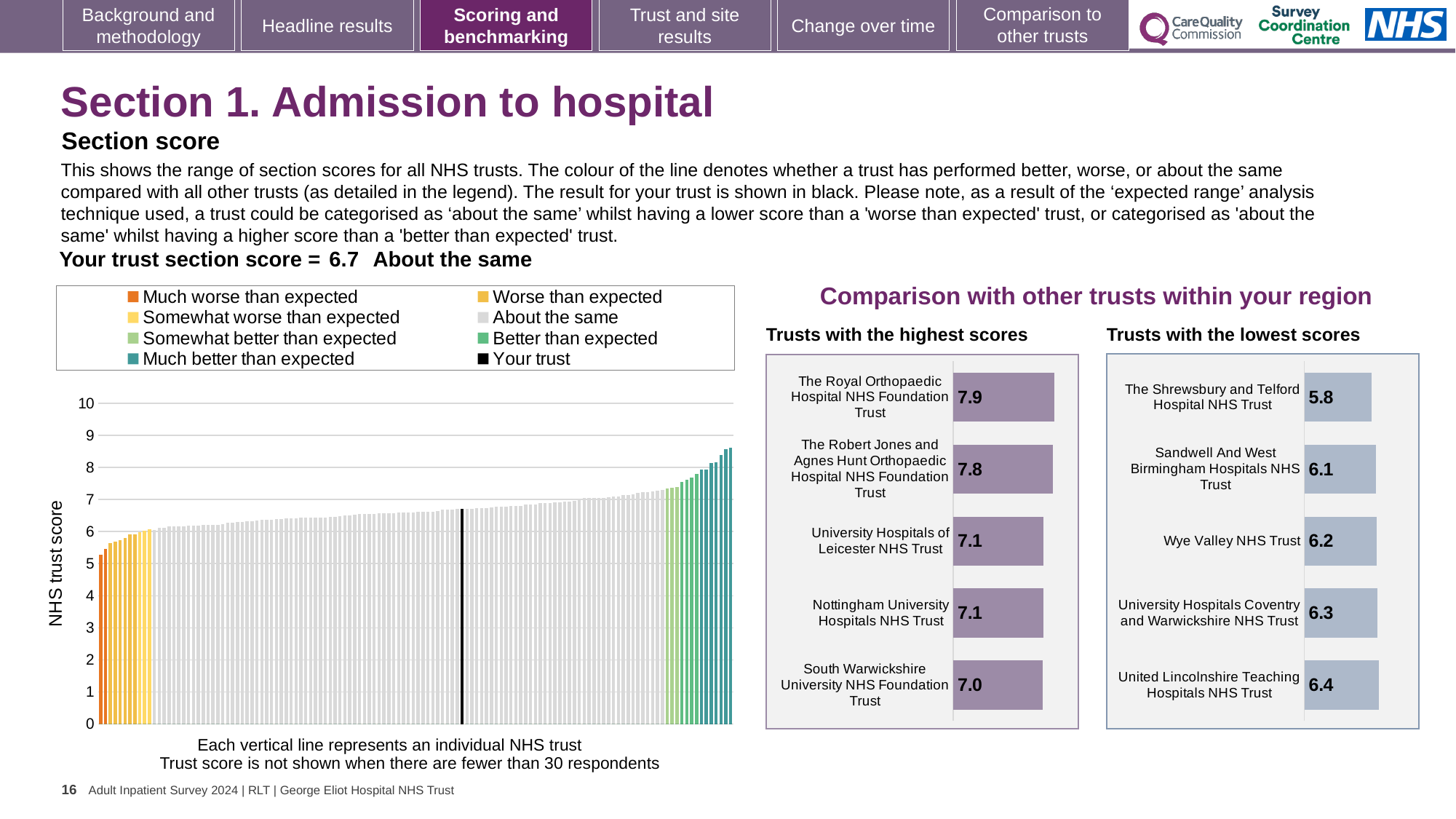
In the main chart on the left, is the value of the tallest bar greater or less than 8? greater How many trusts are shown in the 'Trusts with the highest scores' chart? 5 In the 'Trusts with the highest scores' chart, what is the score for The Royal Orthopaedic Hospital NHS Foundation Trust? 7.9 How many entries does the legend of the main chart on the left list? 8 In the 'Trusts with the highest scores' chart, which trust has the highest score? The Royal Orthopaedic Hospital NHS Foundation Trust In the 'Trusts with the lowest scores' chart, what is the score for Wye Valley NHS Trust? 6.2 In the 'Trusts with the lowest scores' chart, which has the higher score: Sandwell And West Birmingham Hospitals NHS Trust or University Hospitals Coventry and Warwickshire NHS Trust? University Hospitals Coventry and Warwickshire NHS Trust In the 'Trusts with the lowest scores' chart, which trust has the lowest score? The Shrewsbury and Telford Hospital NHS Trust In the main chart on the left showing the range of section scores, what is the section score for your trust (the black line)? 6.7 What type of chart is the 'Trusts with the lowest scores' chart? Bar chart In the 'Trusts with the highest scores' chart, what is the difference between the scores of The Royal Orthopaedic Hospital NHS Foundation Trust and South Warwickshire University NHS Foundation Trust? 0.9 In the 'Trusts with the lowest scores' chart, what is the difference between the scores of United Lincolnshire Teaching Hospitals NHS Trust and The Shrewsbury and Telford Hospital NHS Trust? 0.6